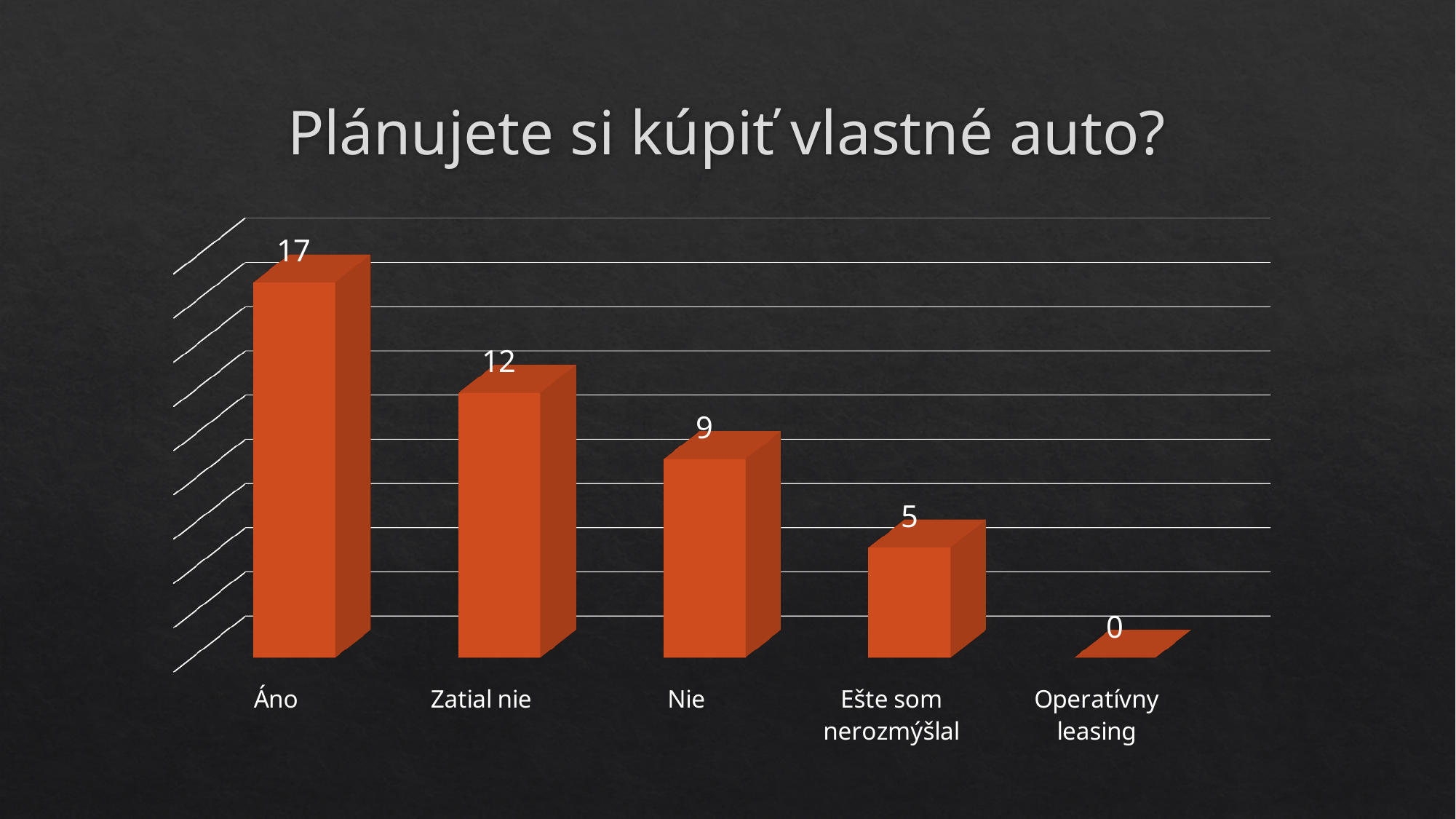
What is the value for "Nie"? 9 Which is larger, the value for "Nie" or the value for "Ešte som nerozmýšlal"? Nie What kind of chart is shown on the slide? Bar chart What is the value for "Áno"? 17 What is the title of the chart? Plánujete si kúpiť vlastné auto? What is the value for "Ešte som nerozmýšlal"? 5 What is the value for "Zatial nie"? 12 Which category has the lowest value? Operatívny leasing What is the value for "Operatívny leasing"? 0 What is the difference between the values for "Áno" and "Zatial nie"? 5 Which category has the highest value? Áno How many categories are shown on the chart? 5